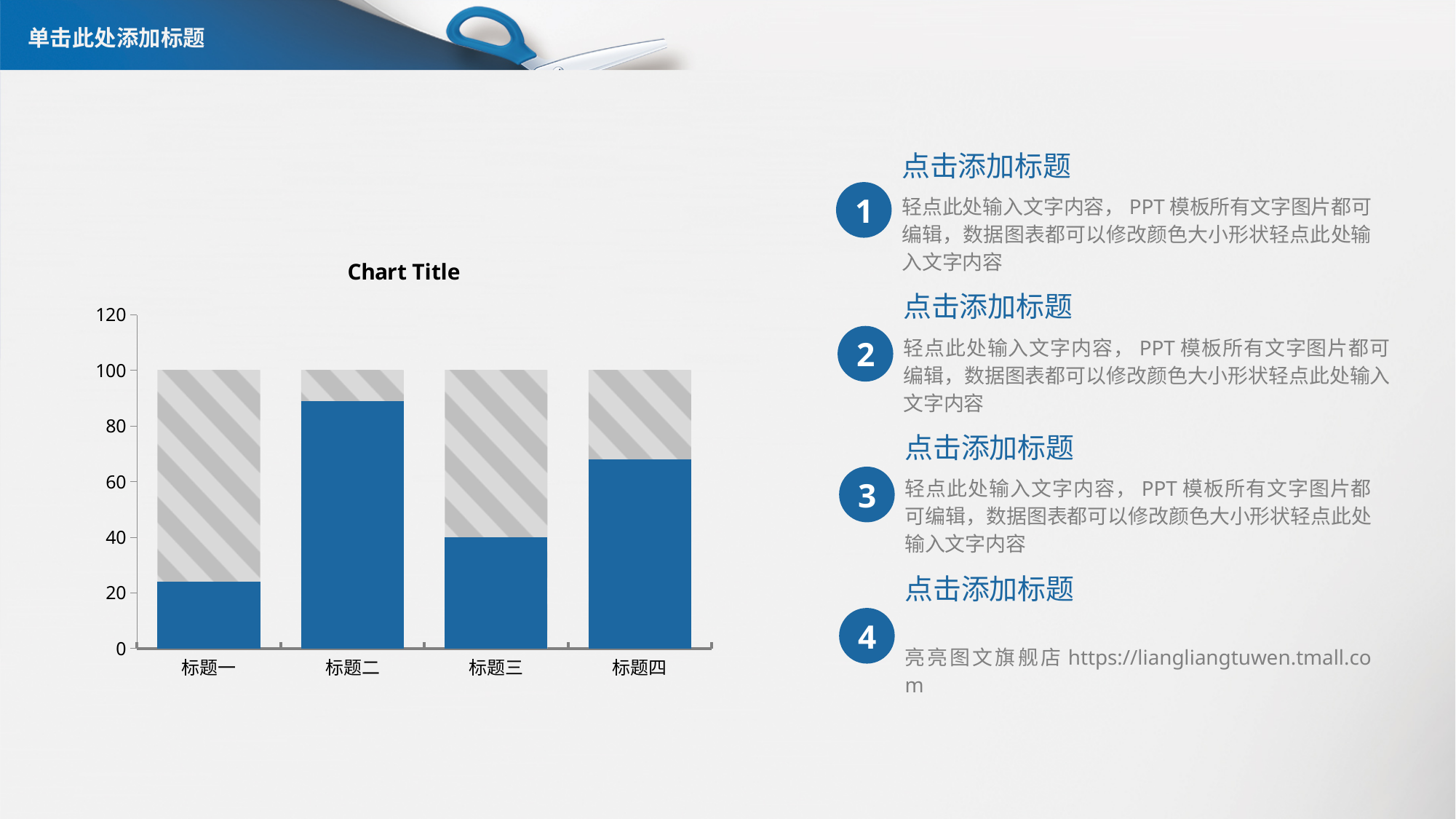
Which category has the tallest blue segment? 标题二 What is the total height of the stacked bar for 标题一? 100 Is the blue value for 标题一 greater or less than 40? less Which category has the shortest blue segment? 标题一 What kind of chart is shown on the slide? bar chart What is the highest value shown on the y axis? 120 Which has the larger blue segment, 标题二 or 标题三? 标题二 What is the title of the chart? Chart Title How many categories are shown on the x axis of the chart? 4 Which has the larger blue segment, 标题四 or 标题一? 标题四 Is the blue value for 标题二 greater or less than 80? greater Is the blue value for 标题四 greater or less than 60? greater